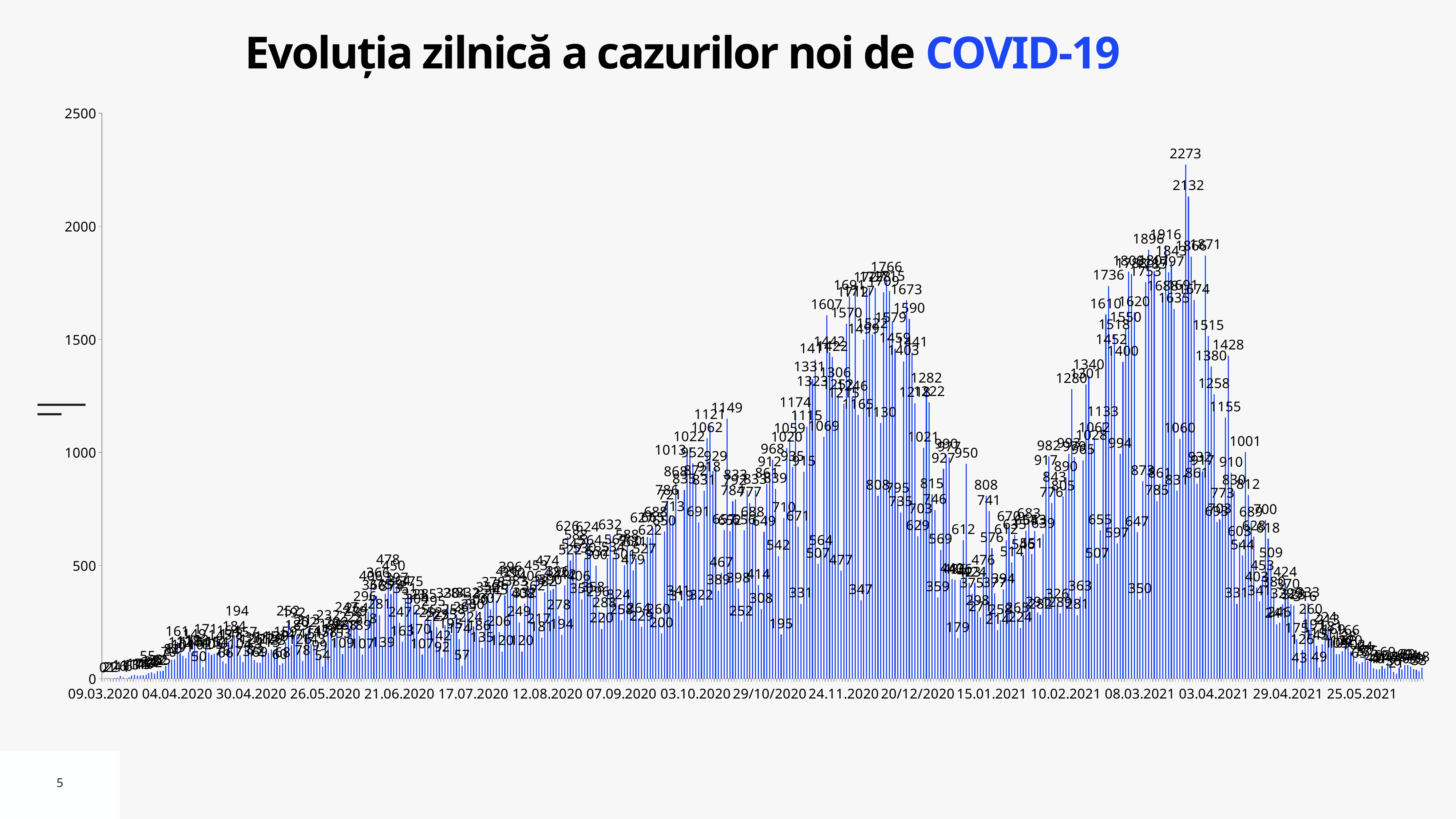
Is the peak value in the wave around 24.11.2020 greater or less than 1500? greater What is the first date label on the x axis? 09.03.2020 What is the highest tick value shown on the y axis? 2500 What is the difference between the two highest labeled values, 2273 and 2132? 141 What is the highest daily value labeled on the chart? 2273 What is the title of the chart? Evoluția zilnică a cazurilor noi de COVID-19 What is the second-highest value labeled on the chart, next to the 2273 peak? 2132 Do the values rise or fall over the final portion of the chart, after 25.05.2021? fall What kind of chart is shown on the slide? bar chart What is the highest value labeled in the wave between 24.11.2020 and 20/12/2020? 1766 Is the highest value on the chart greater or less than 2000? greater Which peak is higher: the one in late 2020 (1766) or the one in spring 2021 (2273)? spring 2021 (2273)